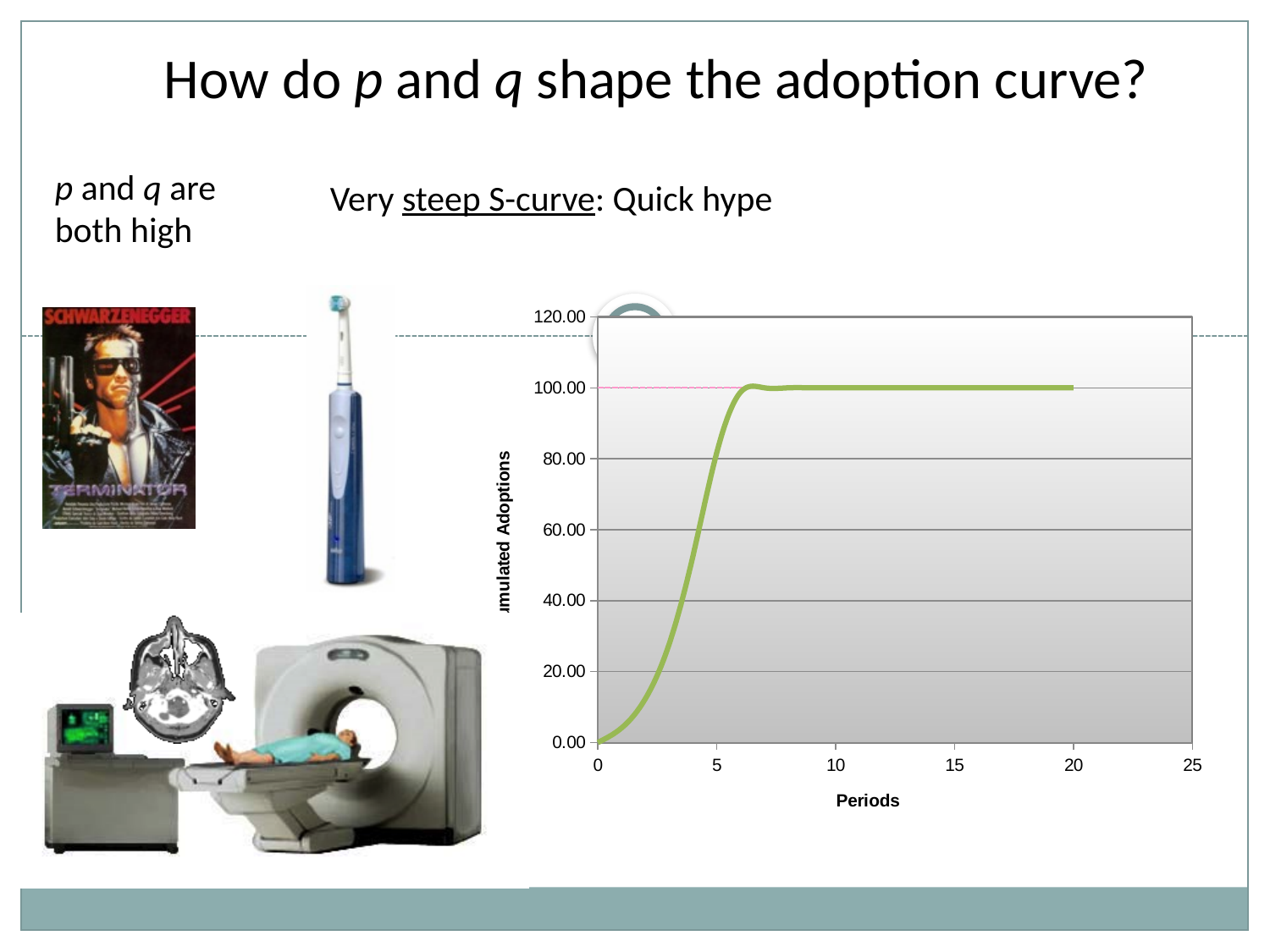
Is the value of the curve at period 20 greater or less than 80.00? greater Is the value of the curve at period 10 greater or less than 80.00? greater What is the value of the curve at period 0? 0.00 What is the highest tick value shown on the y axis of the chart? 120.00 Is the value of the curve at period 2 greater or less than 40.00? less Do the cumulated adoptions rise or fall as the periods increase from 0 to 5? rise What kind of chart is shown on the slide? line chart What is the title of the x axis of the chart? Periods